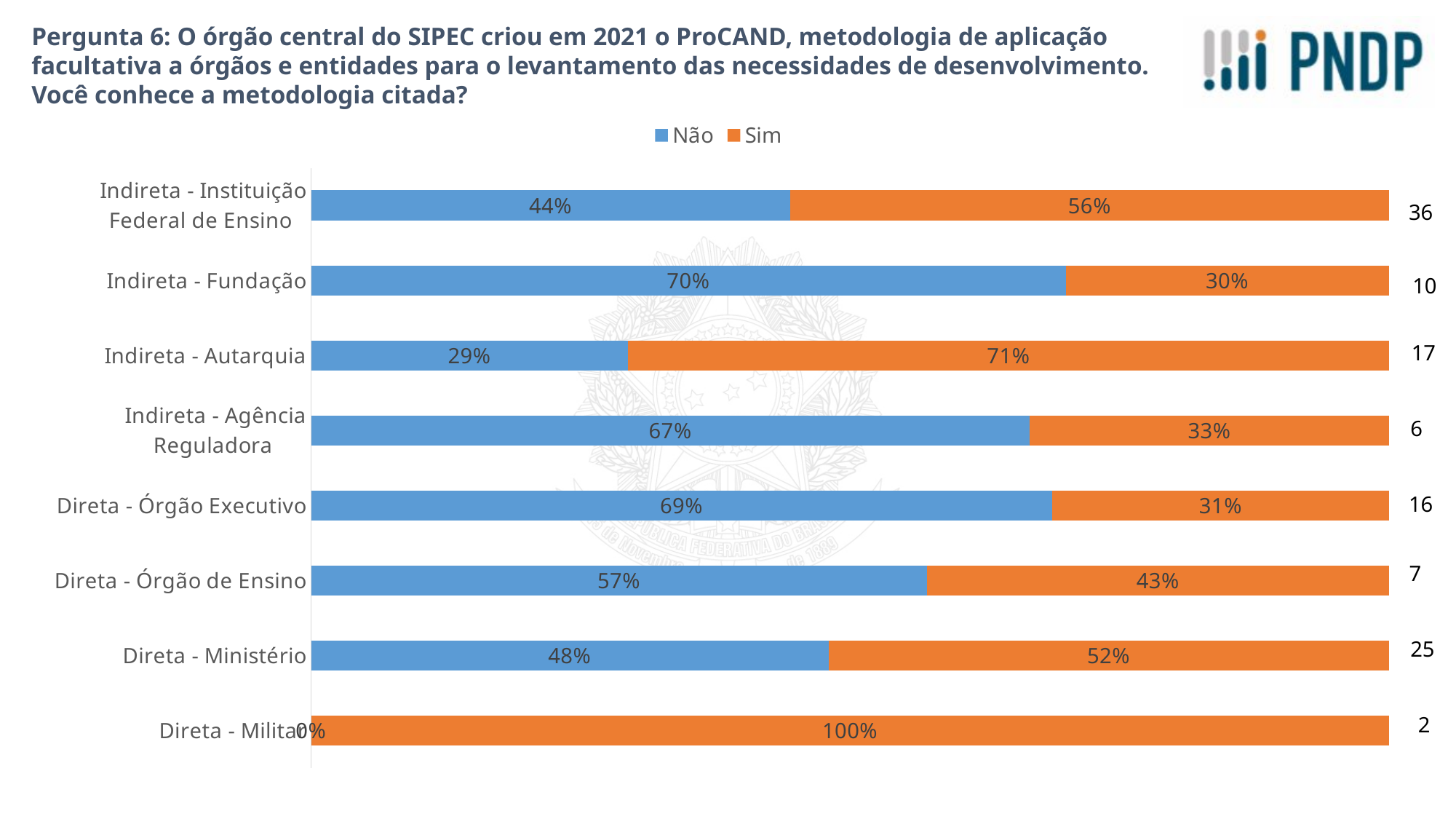
Which category has the lowest 'Não' percentage among those with a non-zero 'Não' share? Indireta - Autarquia What percentage of 'Indireta - Fundação' respondents answered 'Não'? 70% How many series does the legend list? 2 How many categories are shown on the chart? 8 Which category has the highest 'Sim' percentage? Direta - Militar What is the 'Sim' value for 'Direta - Ministério'? 52% Which colour represents the 'Sim' series in the chart? Orange What is the difference between the 'Não' and 'Sim' percentages for 'Direta - Órgão Executivo'? 38% What is the 'Não' value for 'Direta - Órgão de Ensino'? 57% Which is larger for 'Indireta - Instituição Federal de Ensino': the 'Não' share or the 'Sim' share? Sim What percentage of 'Indireta - Autarquia' respondents answered 'Sim'? 71% What kind of chart is shown on the slide? Stacked bar chart